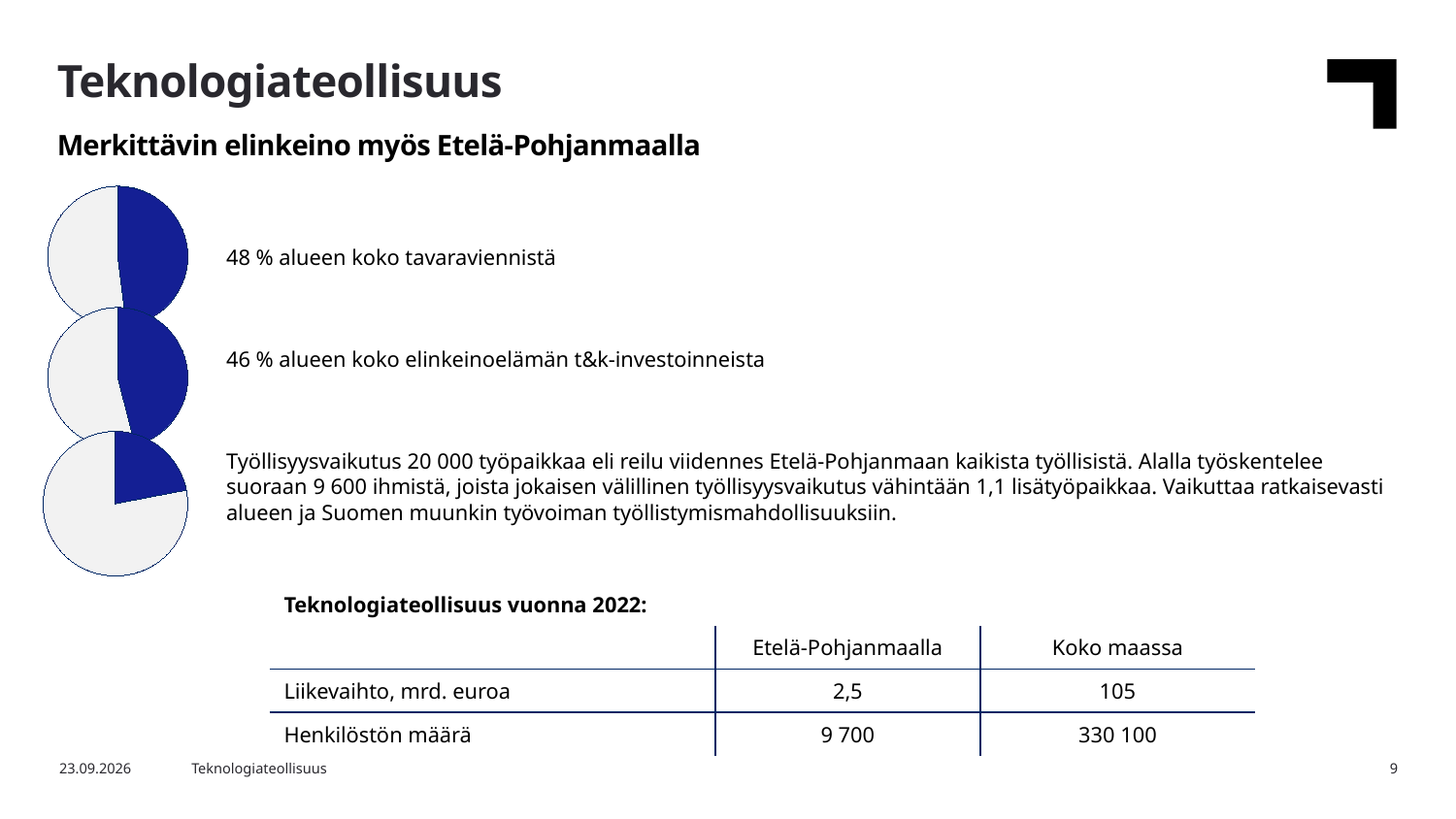
What does the text next to the bottom pie chart say the employment effect is in jobs? 20 000 How many pie charts are on the slide? 3 Which pie chart has the smallest highlighted (blue) slice: the top, middle or bottom one? Bottom What is the difference between the share shown for the top pie chart (48 %) and the middle pie chart (46 %)? 2 percentage points What kind of charts are shown on the left side of the slide? Pie charts What share of the region's business R&D investments does the middle pie chart represent, according to the text next to it? 46 % What share of the region's total goods exports does the top pie chart represent, according to the text next to it? 48 % What colour is the highlighted slice in each pie chart? Blue Is the highlighted share in the top pie chart (48 %) larger or smaller than the highlighted share in the middle pie chart (46 %)? Larger